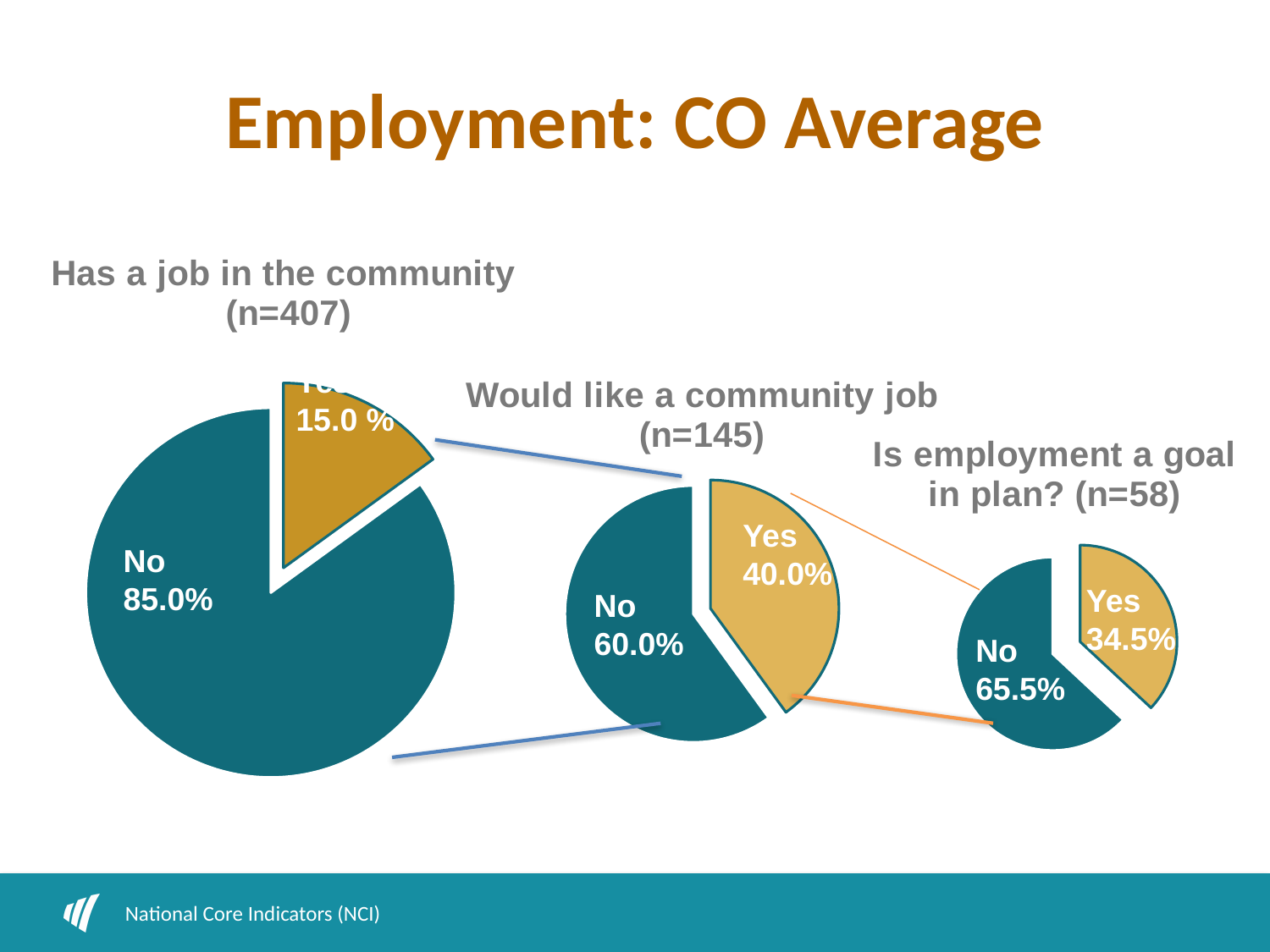
In the 'Has a job in the community (n=407)' pie chart, what percentage is labelled 'No'? 85.0% What is the sample size (n) shown for the 'Is employment a goal in plan?' chart? 58 In the 'Would like a community job (n=145)' pie chart, what is the difference between the 'No' and 'Yes' percentages? 20.0% In the 'Is employment a goal in plan? (n=58)' pie chart, what percentage answered 'Yes'? 34.5% In the 'Would like a community job (n=145)' pie chart, what percentage answered 'No'? 60.0% How many pie charts are shown on the slide? 3 In the 'Is employment a goal in plan? (n=58)' pie chart, which slice is larger, 'Yes' or 'No'? No In the 'Is employment a goal in plan? (n=58)' pie chart, what percentage answered 'No'? 65.5% In the 'Has a job in the community (n=407)' pie chart, what is the difference between the 'No' and 'Yes' percentages? 70.0% In the 'Has a job in the community (n=407)' pie chart, what percentage is labelled 'Yes'? 15.0 % In the 'Would like a community job (n=145)' pie chart, what percentage answered 'Yes'? 40.0% What type of chart is used for 'Would like a community job (n=145)'? Pie chart